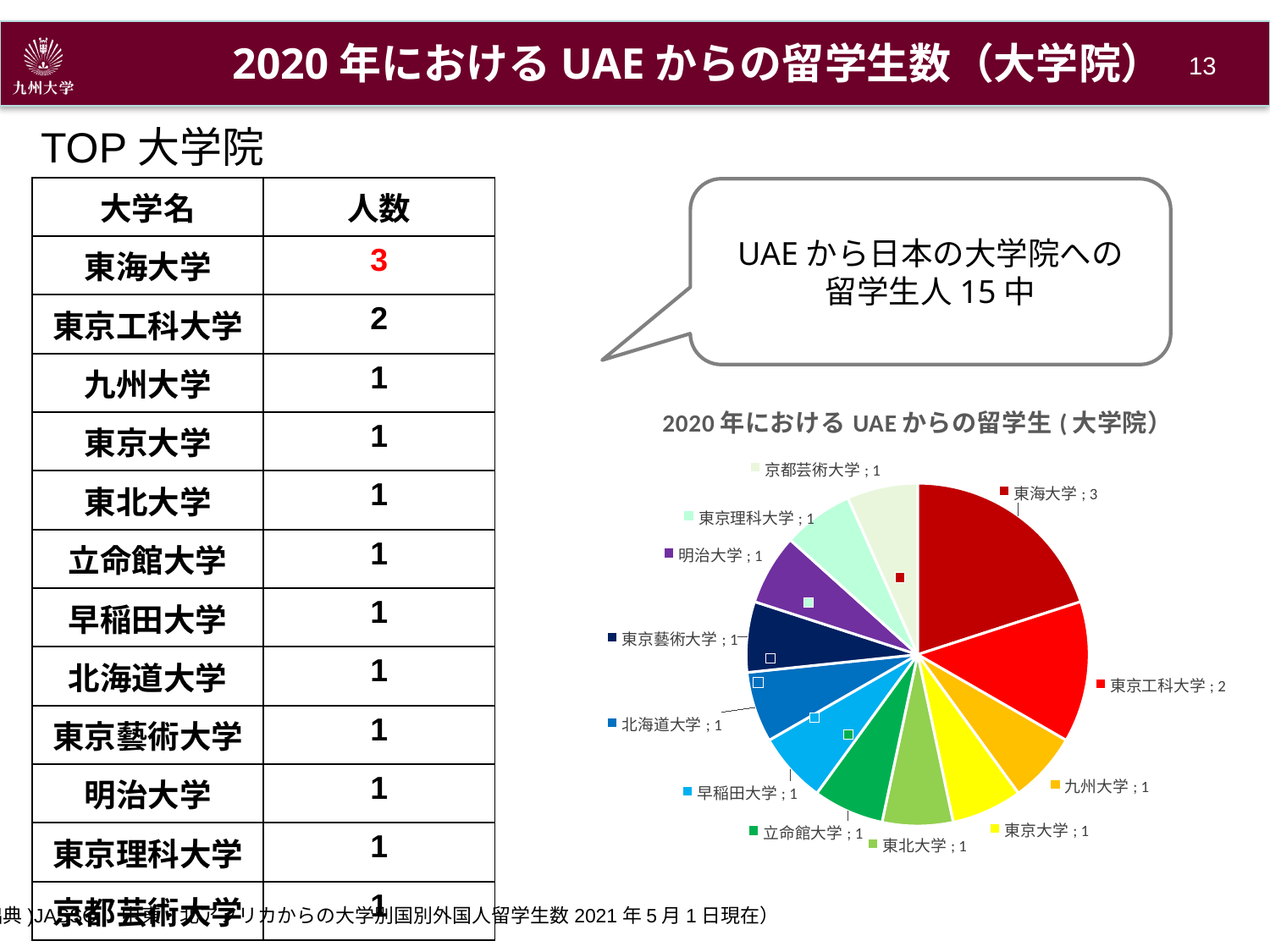
How many universities in the pie chart have a value of 1? 10 What is the title of the pie chart? 2020年におけるUAEからの留学生(大学院) What is the total of all slices in the pie chart? 15 Which is larger, the value for 東京工科大学 or the value for 明治大学? 東京工科大学 What is the difference between the values for 東海大学 and 東京工科大学? 1 How many slices does the pie chart have? 12 What is the value for 東海大学 in the pie chart? 3 What is the value for 東京工科大学 in the pie chart? 2 Which university has the largest slice in the pie chart? 東海大学 What kind of chart is shown on the slide? pie chart What share of the pie does 東海大学 represent? 20% What is the value for 九州大学 in the pie chart? 1